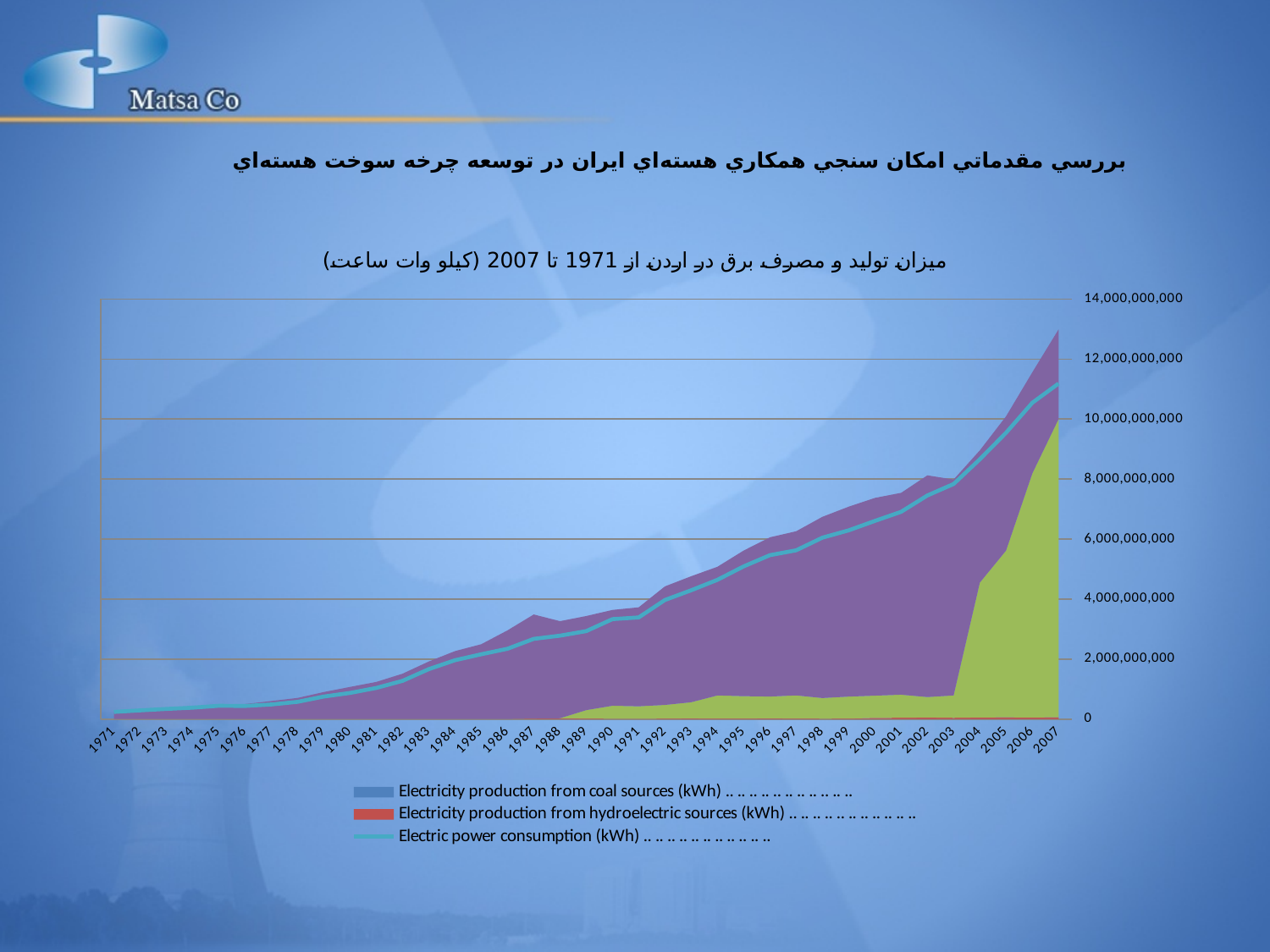
Is the value of the Electric power consumption (kWh) line in 1990 greater or less than 4,000,000,000? less Does the Electric power consumption (kWh) line generally rise or fall from 1971 to 2007? rise How many series does the legend list? 3 What is the last year shown on the x axis? 2007 What kind of chart is shown on the slide? Area and line chart How many years are plotted along the x axis? 37 Is the value of the Electric power consumption (kWh) line in 2000 greater or less than 6,000,000,000? greater Is the value of the Electric power consumption (kWh) line in 2007 greater or less than 10,000,000,000? greater In which year does the Electric power consumption (kWh) line reach its highest value? 2007 What is the first year shown on the x axis? 1971 What is the highest value shown on the y axis? 14,000,000,000